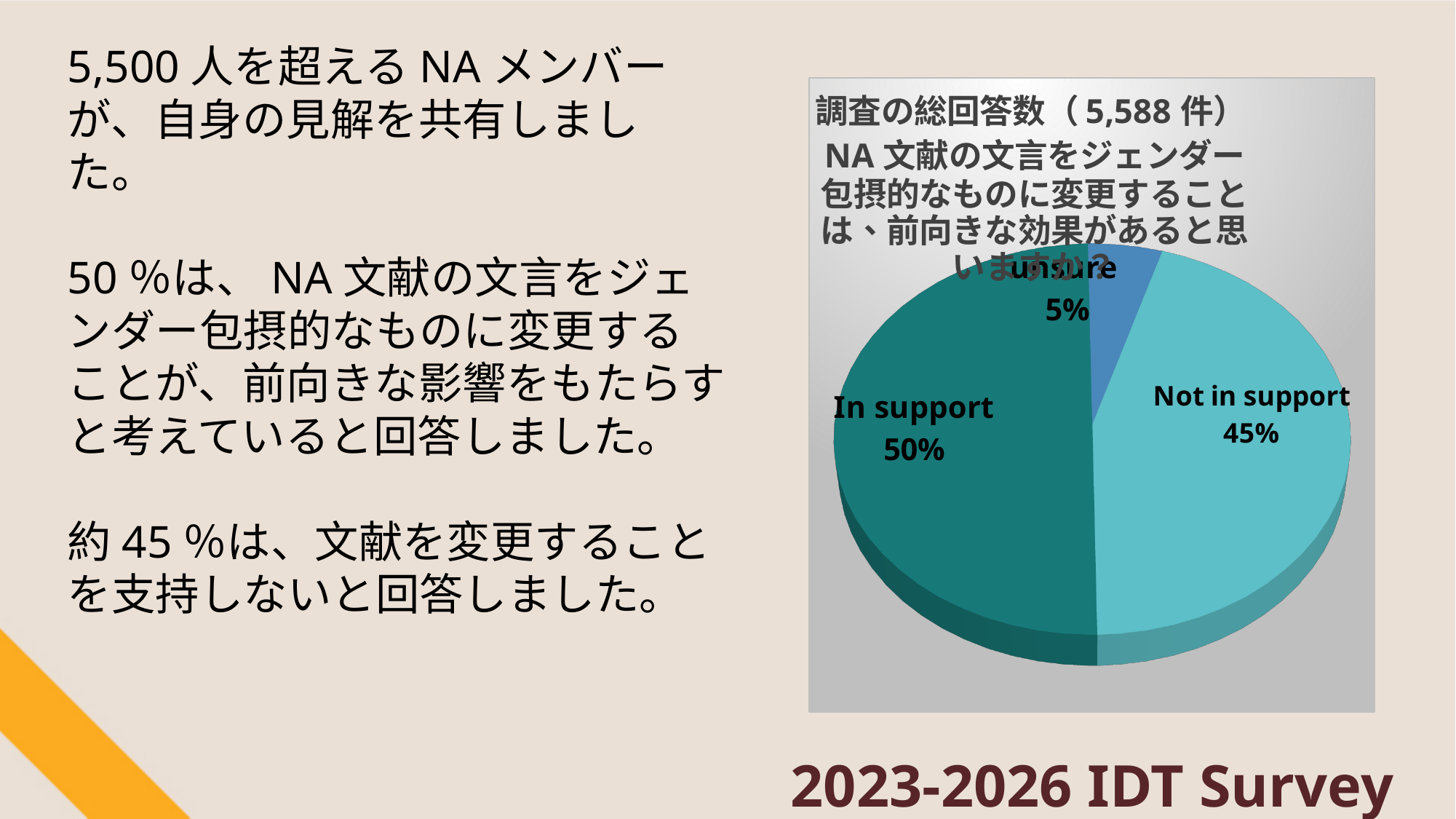
Which is larger, the "Not in support" slice or the "unsure" slice? Not in support What share of the pie is labelled "Not in support"? 45% What share of the pie is labelled "In support"? 50% What colour is the "unsure" slice of the pie? blue What kind of chart is shown on the slide? pie chart What is the difference in percentage points between the "In support" and "Not in support" slices? 5% Which slice of the pie is the smallest? unsure How many slices does the pie chart have? 3 What total number of survey responses is stated in the chart's title area? 5,588 Which slice of the pie is the largest? In support What is the difference in percentage points between the "Not in support" and "unsure" slices? 40% What share of the pie is labelled "unsure"? 5%